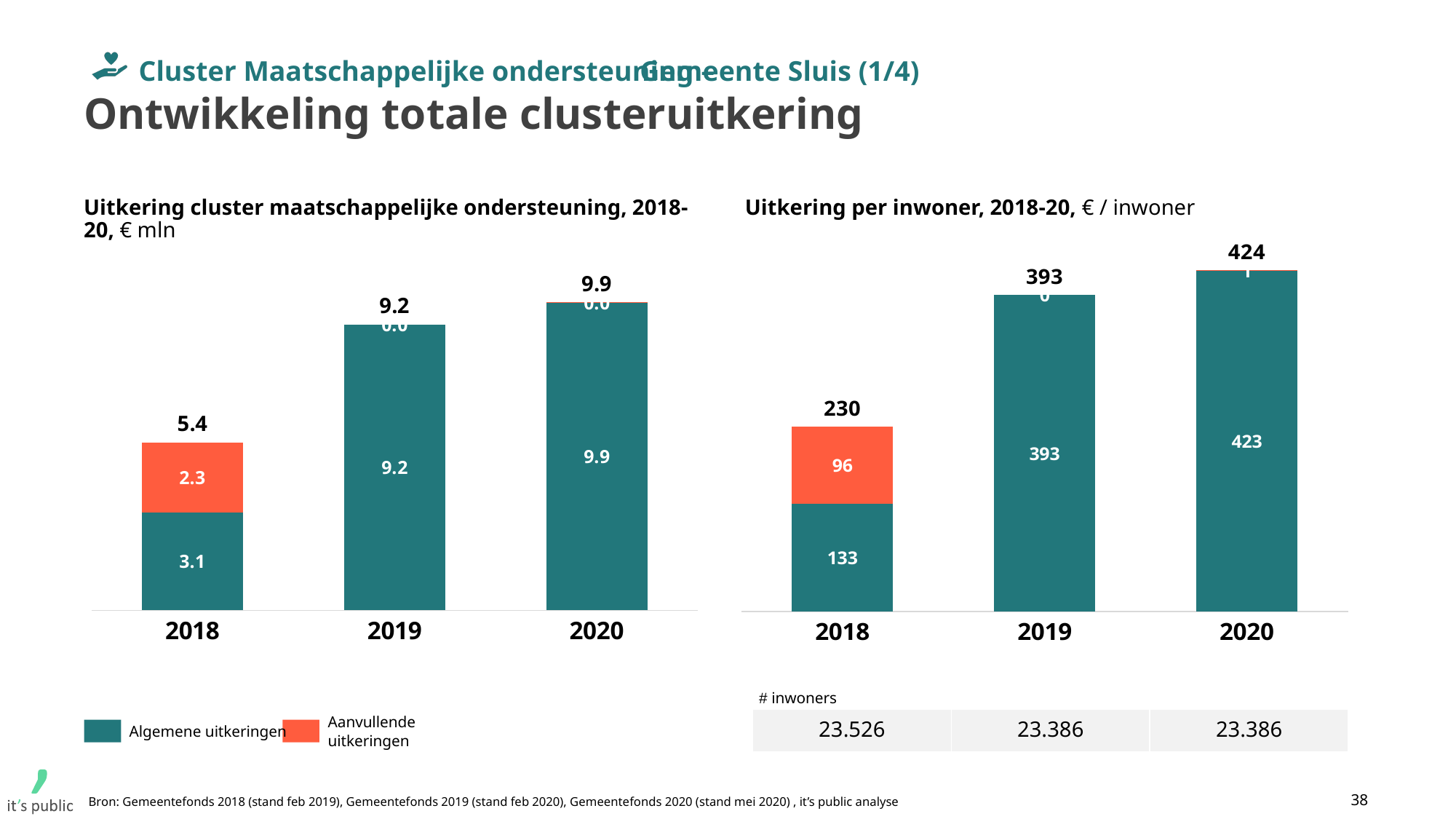
How many series does the legend on the slide list? 2 In the left chart (Uitkering cluster maatschappelijke ondersteuning), which year has the highest total? 2020 In the right chart (Uitkering per inwoner), what is the value of Aanvullende uitkeringen for 2018? 96 In the left chart (Uitkering cluster maatschappelijke ondersteuning), do the totals rise or fall from 2018 to 2020? rise In the right chart (Uitkering per inwoner), what is the total for 2020? 424 In the right chart (Uitkering per inwoner), which year has the lowest total? 2018 In the right chart (Uitkering per inwoner), what is the value of Algemene uitkeringen for 2018? 133 In the left chart (Uitkering cluster maatschappelijke ondersteuning), what is the total of the stacked bar for 2018? 5.4 In the left chart (Uitkering cluster maatschappelijke ondersteuning), what is the value of Aanvullende uitkeringen for 2018? 2.3 In the left chart (Uitkering cluster maatschappelijke ondersteuning), what is the value of Algemene uitkeringen for 2018? 3.1 In the left chart (Uitkering cluster maatschappelijke ondersteuning), what is the difference between the totals for 2020 and 2019? 0.7 In the right chart (Uitkering per inwoner), what is the difference between the totals for 2019 and 2018? 163